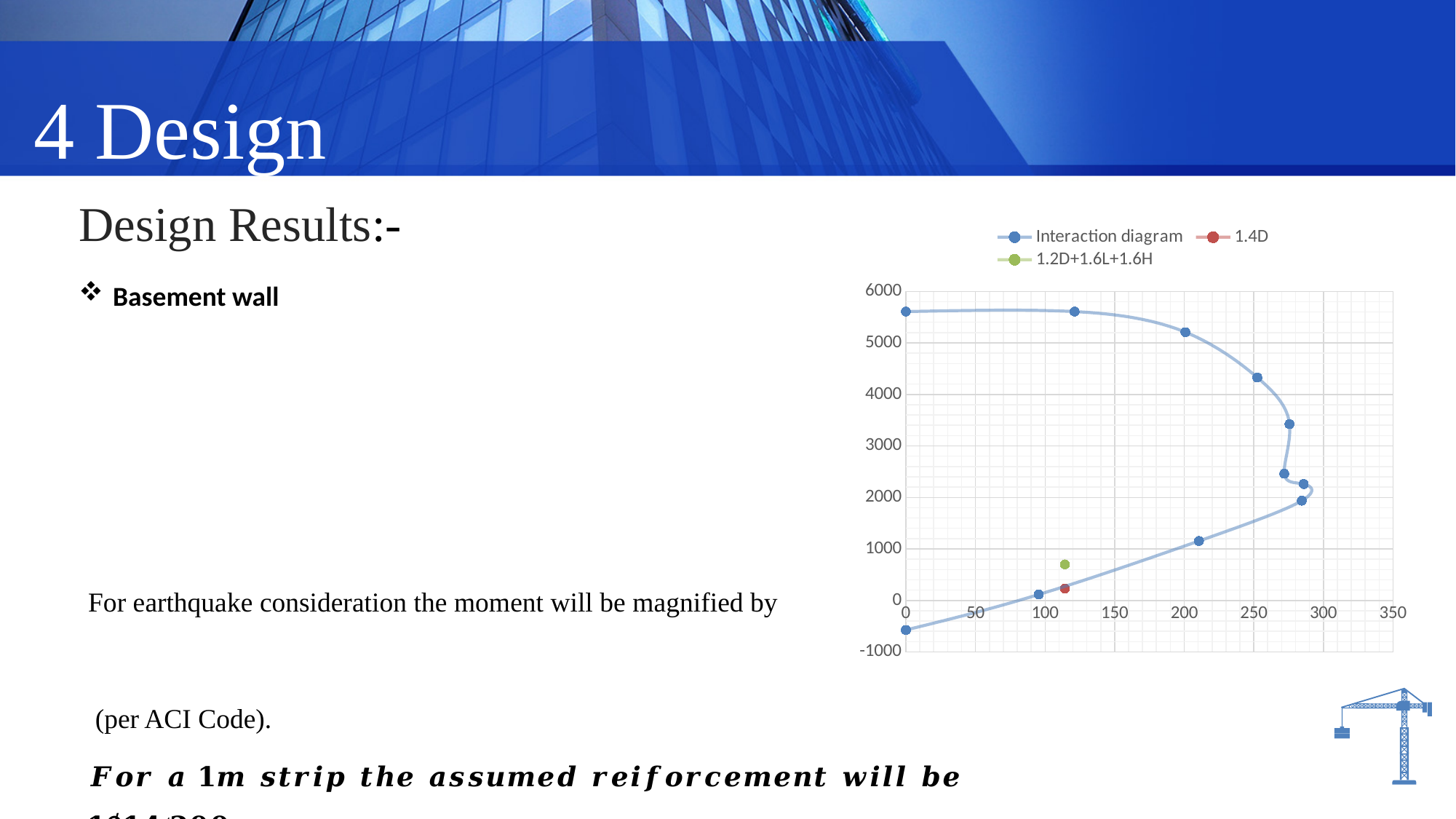
Is the highest vertical-axis value reached by the Interaction diagram series greater or less than 5000? greater Which series is drawn in red in the chart? 1.4D What kind of chart is shown on the slide? scatter chart with lines Is the lowest vertical-axis value of the Interaction diagram series greater or less than 0? less Is the vertical-axis value of the 1.4D point greater or less than 1000? less How many data points are plotted for the Interaction diagram series? 11 Which point lies higher on the vertical axis, 1.4D or 1.2D+1.6L+1.6H? 1.2D+1.6L+1.6H How many series does the chart legend list? 3 Which series is drawn in green in the chart? 1.2D+1.6L+1.6H